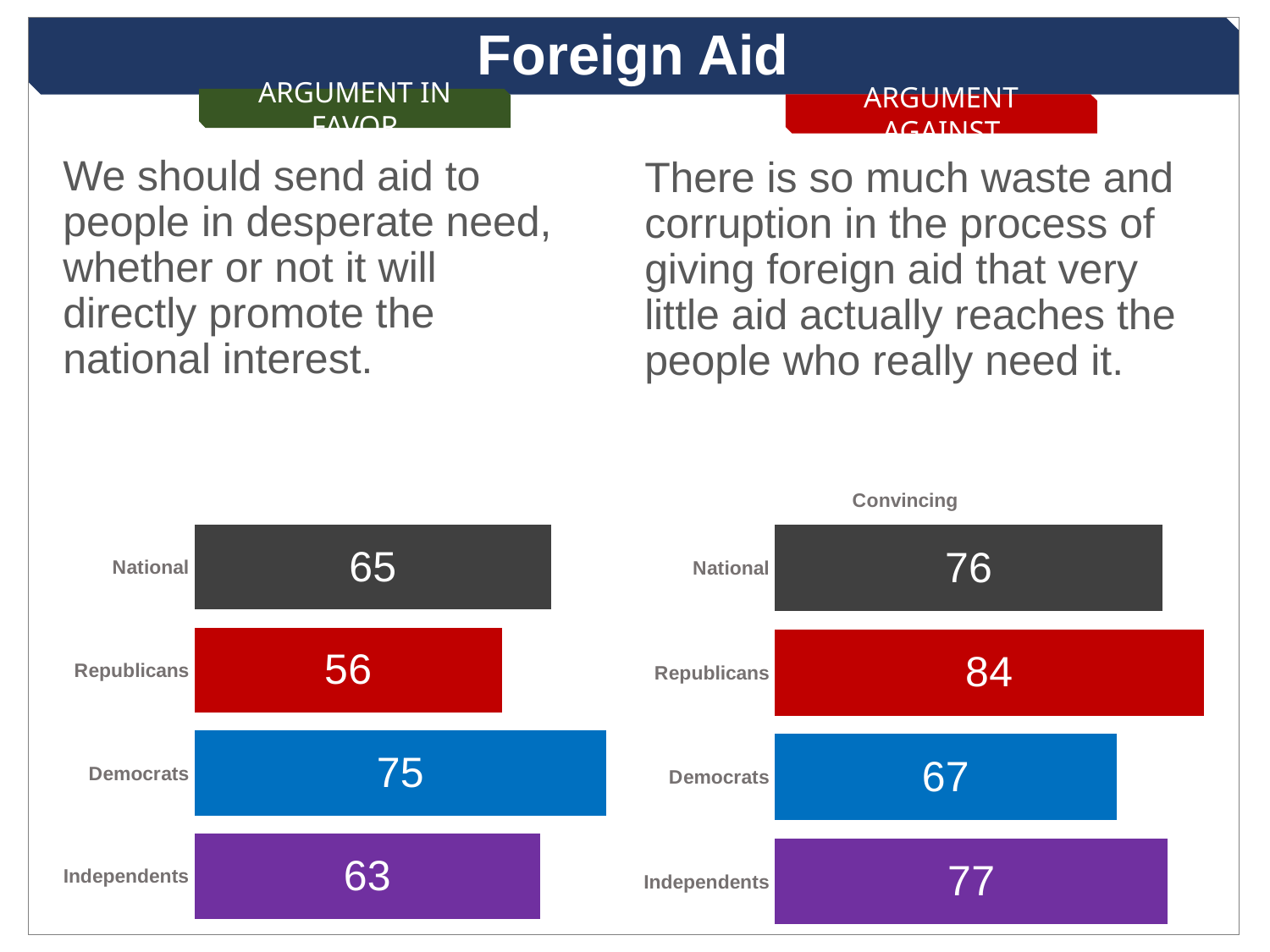
In the right chart (Argument Against), which category has the lowest value? Democrats In the right chart (Argument Against), which is larger, the value for National or the value for Independents? Independents How many categories are shown in the left chart (Argument in Favor)? 4 In the right chart (Argument Against), what is the value for Independents? 77 In the left chart (Argument in Favor), which category has the highest value? Democrats In the left chart (Argument in Favor), what is the value for National? 65 In the left chart (Argument in Favor), what is the value for Democrats? 75 In the left chart (Argument in Favor), which category has the lowest value? Republicans In the right chart (Argument Against), what is the value for Republicans? 84 In the left chart (Argument in Favor), what is the difference between the Democrats and Republicans values? 19 In the right chart (Argument Against), what is the difference between the Republicans and Democrats values? 17 What kind of chart is the right chart (Argument Against)? Bar chart